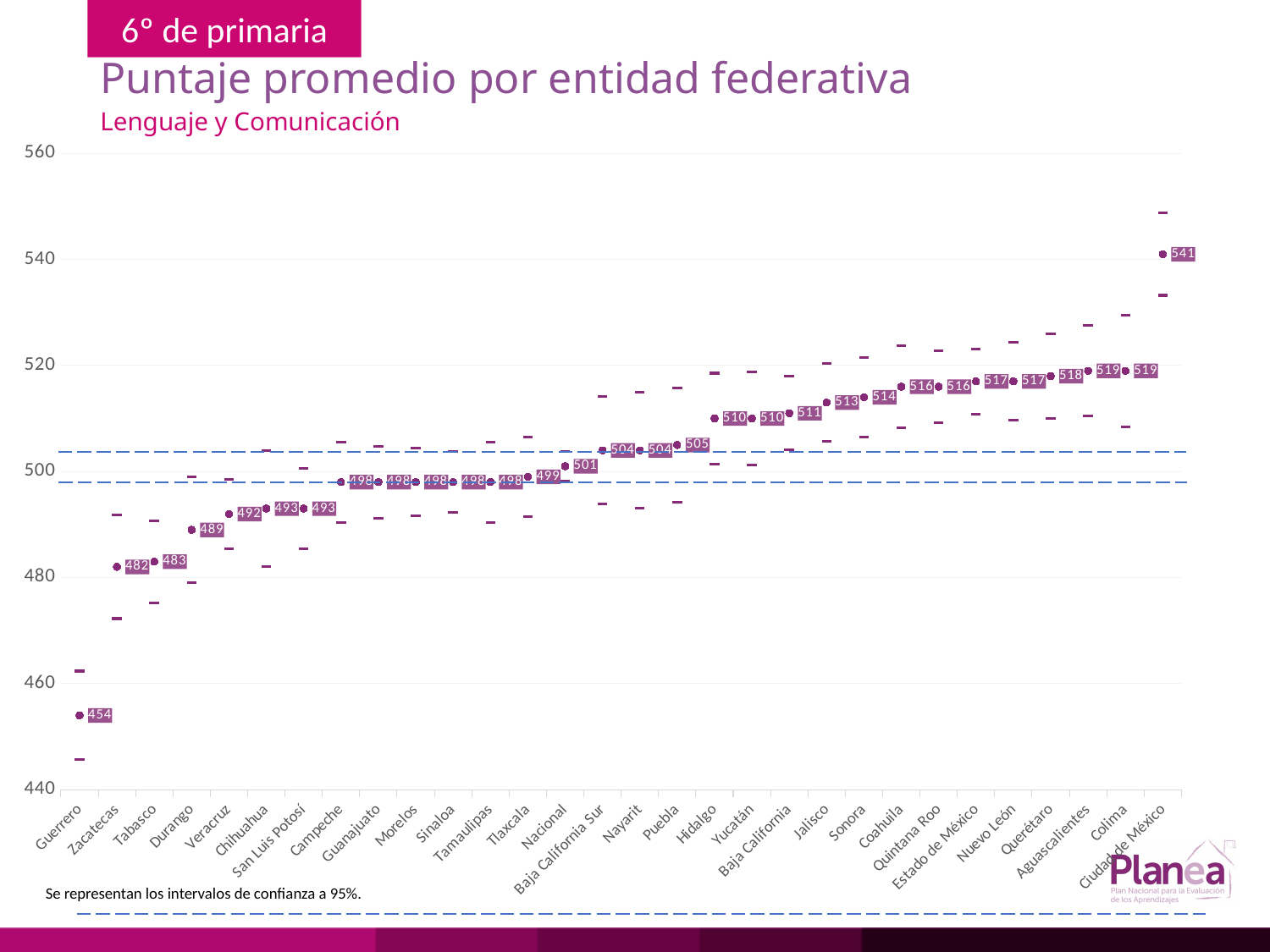
Which entity has the highest average score? Ciudad de México What is the average score shown for Jalisco? 513 What is the average score shown for Guerrero? 454 What is the difference between the scores of Ciudad de México and Guerrero? 87 How many entities (including Nacional) are plotted on the x axis? 30 Do the plotted values rise or fall from left to right along the x axis? rise Which has a higher score, Hidalgo or Durango? Hidalgo What is the value plotted for Nacional? 501 According to the note at the bottom, what confidence level do the intervals represent? 95% What subject is named in the chart's subtitle? Lenguaje y Comunicación Which entity has the lowest average score? Guerrero What is the average score shown for Ciudad de México? 541